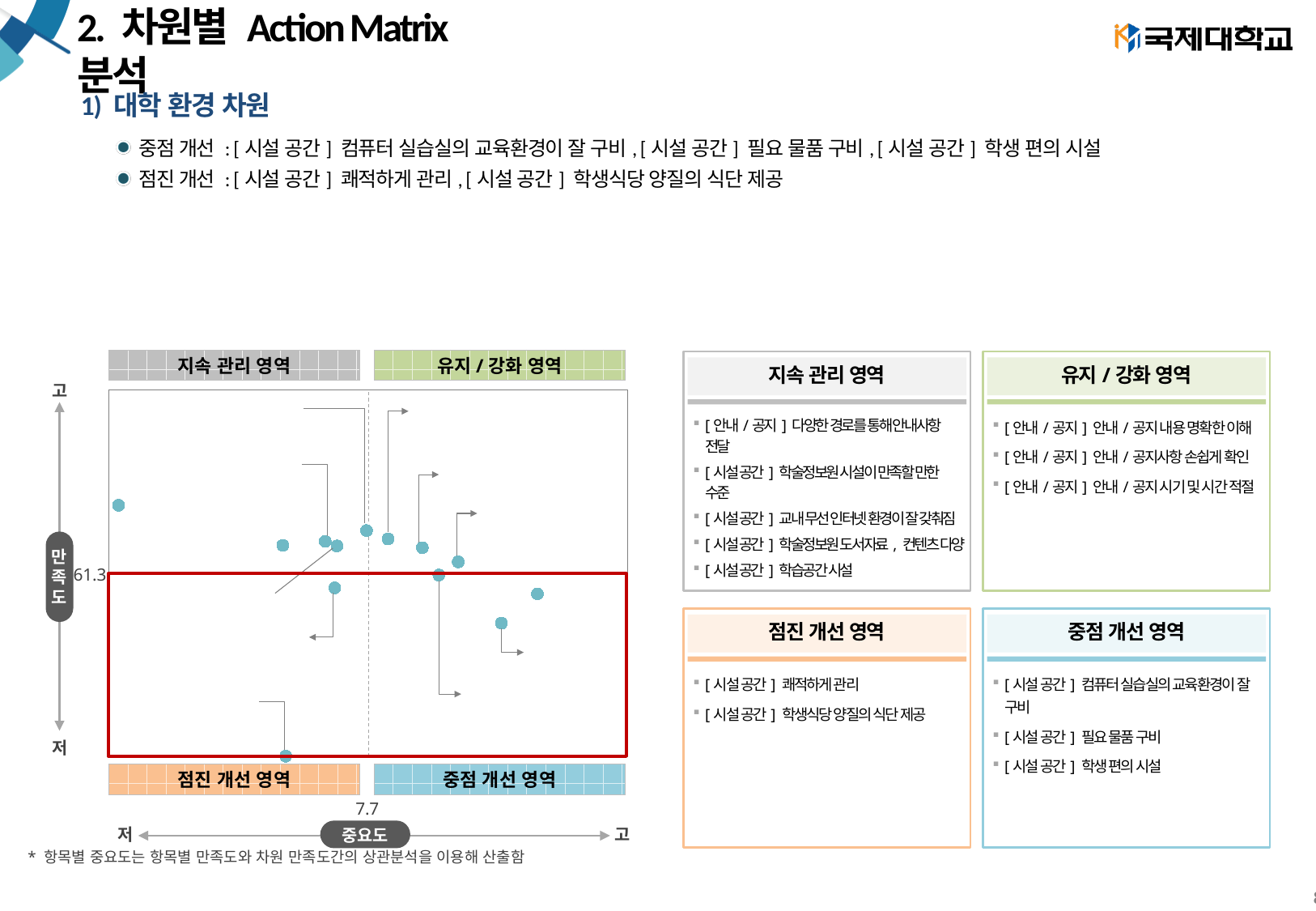
Is the 중요도 value of the rightmost point in the Action Matrix greater or less than 7.7? greater In the Action Matrix, which quadrant label appears at the bottom-right of the plot? 중점 개선 영역 What 중요도 value marks the vertical reference line in the Action Matrix? 7.7 How many points fall in the 점진 개선 영역 quadrant of the Action Matrix? 2 Is the 만족도 value of the leftmost point in the Action Matrix greater or less than 61.3? greater What 만족도 value marks the horizontal reference line in the Action Matrix? 61.3 Is the 만족도 value of the lowest point in the Action Matrix greater or less than 61.3? less In the Action Matrix, which quadrant label appears at the top-left of the plot? 지속 관리 영역 What kind of chart is the Action Matrix on the left of the slide? scatter chart How many points fall in the 중점 개선 영역 quadrant of the Action Matrix? 3